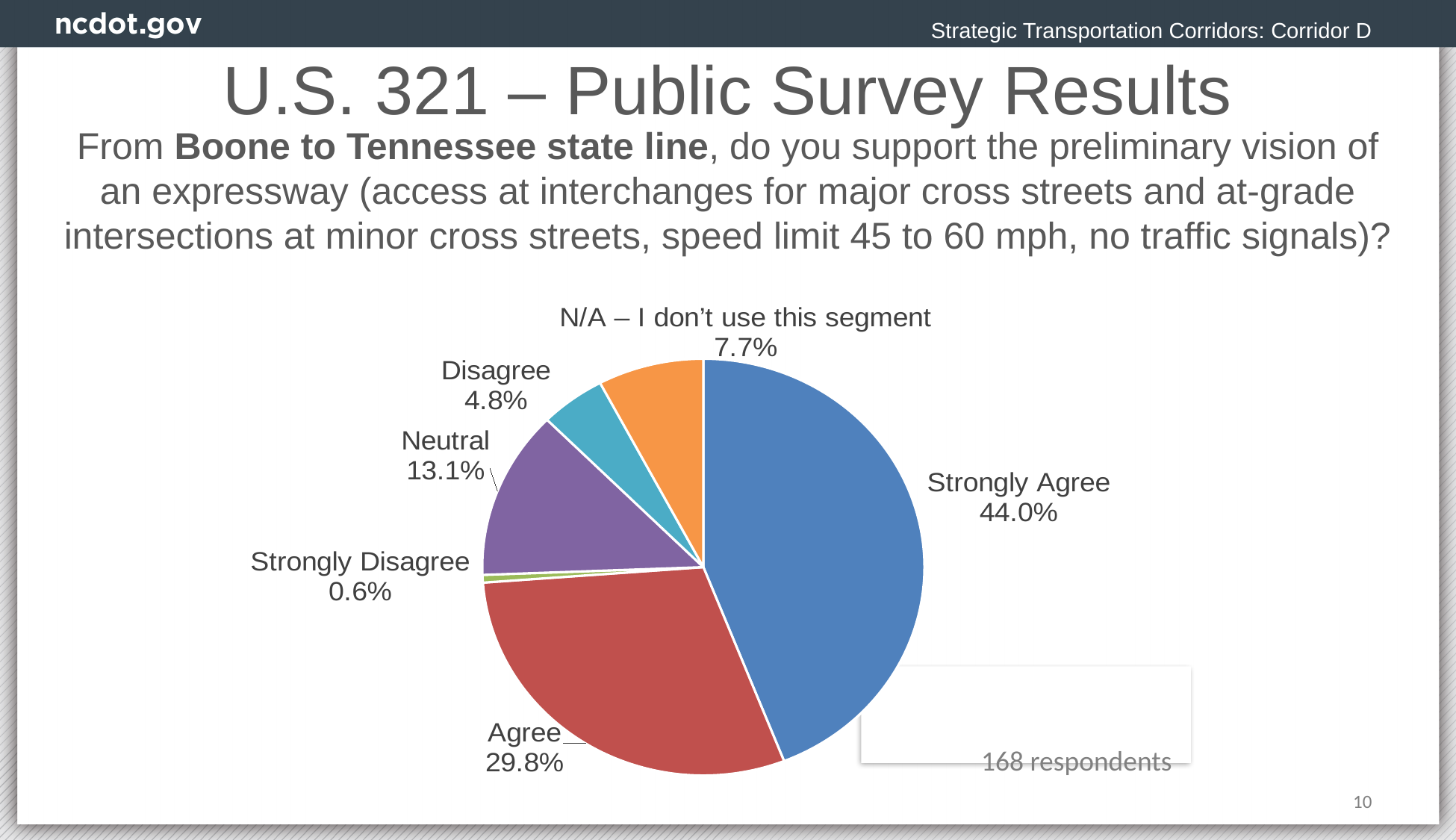
What is the difference in percentage points between Strongly Agree and Agree? 14.2 What share of respondents answered N/A – I don't use this segment? 7.7% How many slices does the pie chart have? 6 What kind of chart is shown on the slide? pie chart What share of respondents answered Neutral? 13.1% Which response category has the smallest slice of the pie? Strongly Disagree What share of respondents answered Strongly Agree? 44.0% How many respondents does the chart note say took the survey? 168 respondents What share of respondents answered Disagree? 4.8% Which response category has the largest slice of the pie? Strongly Agree What share of respondents answered Strongly Disagree? 0.6% What share of respondents answered Agree? 29.8%